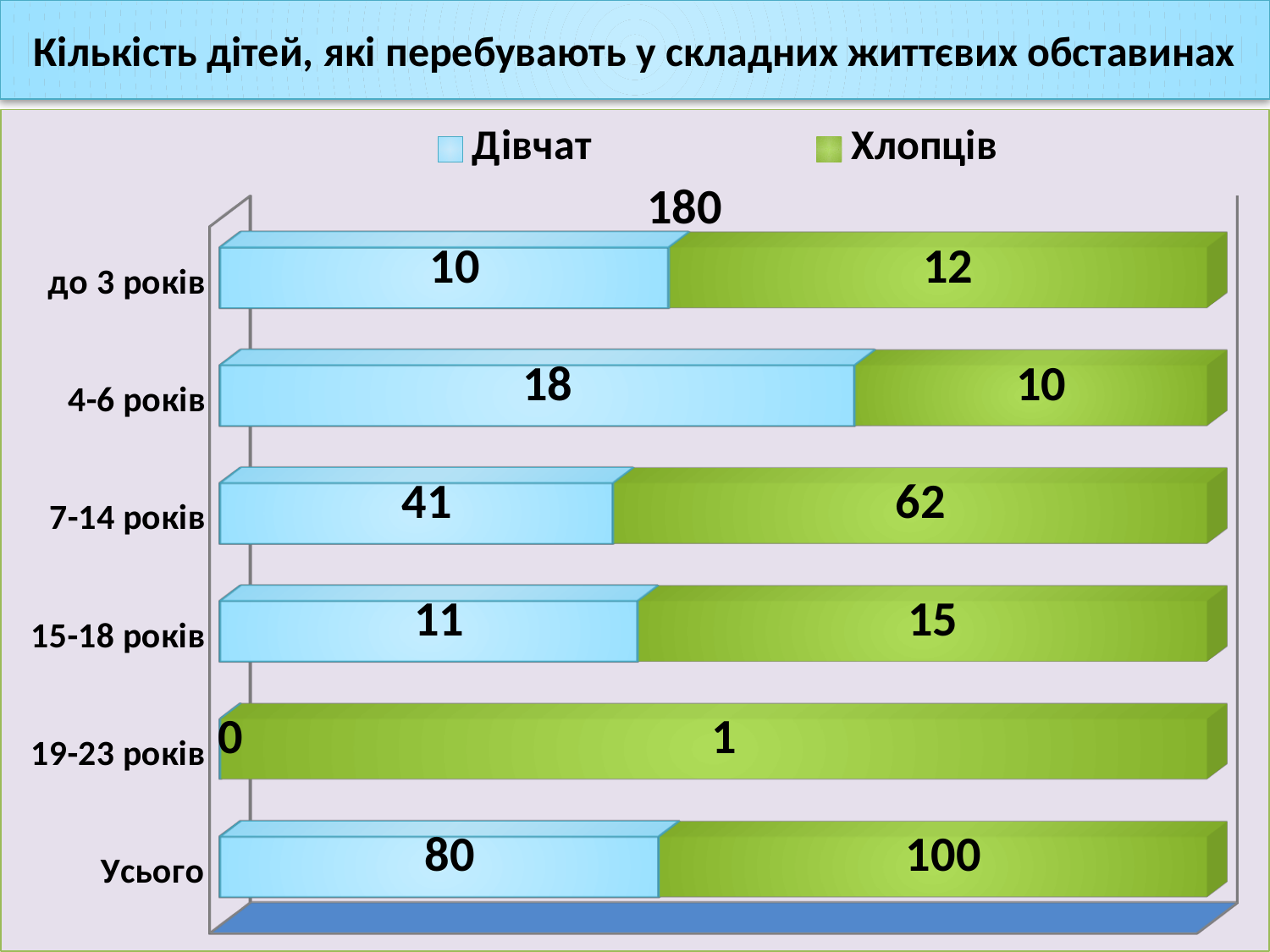
Which age category (excluding Усього) has the lowest value for Дівчат? 19-23 років How many series does the legend list? 2 How many age categories (including Усього) are shown on the chart? 6 What is the value for Дівчат in the 19-23 років category? 0 What is the value for Хлопців in the 4-6 років category? 10 Which age category (excluding Усього) has the highest value for Хлопців? 7-14 років What kind of chart is shown on the slide? bar chart What is the difference between Хлопців and Дівчат in the 7-14 років category? 21 What is the value for Хлопців in the Усього category? 100 In the 4-6 років category, which is larger: Дівчат or Хлопців? Дівчат What is the value for Дівчат in the 7-14 років category? 41 What is the total of Дівчат and Хлопців in the Усього category? 180